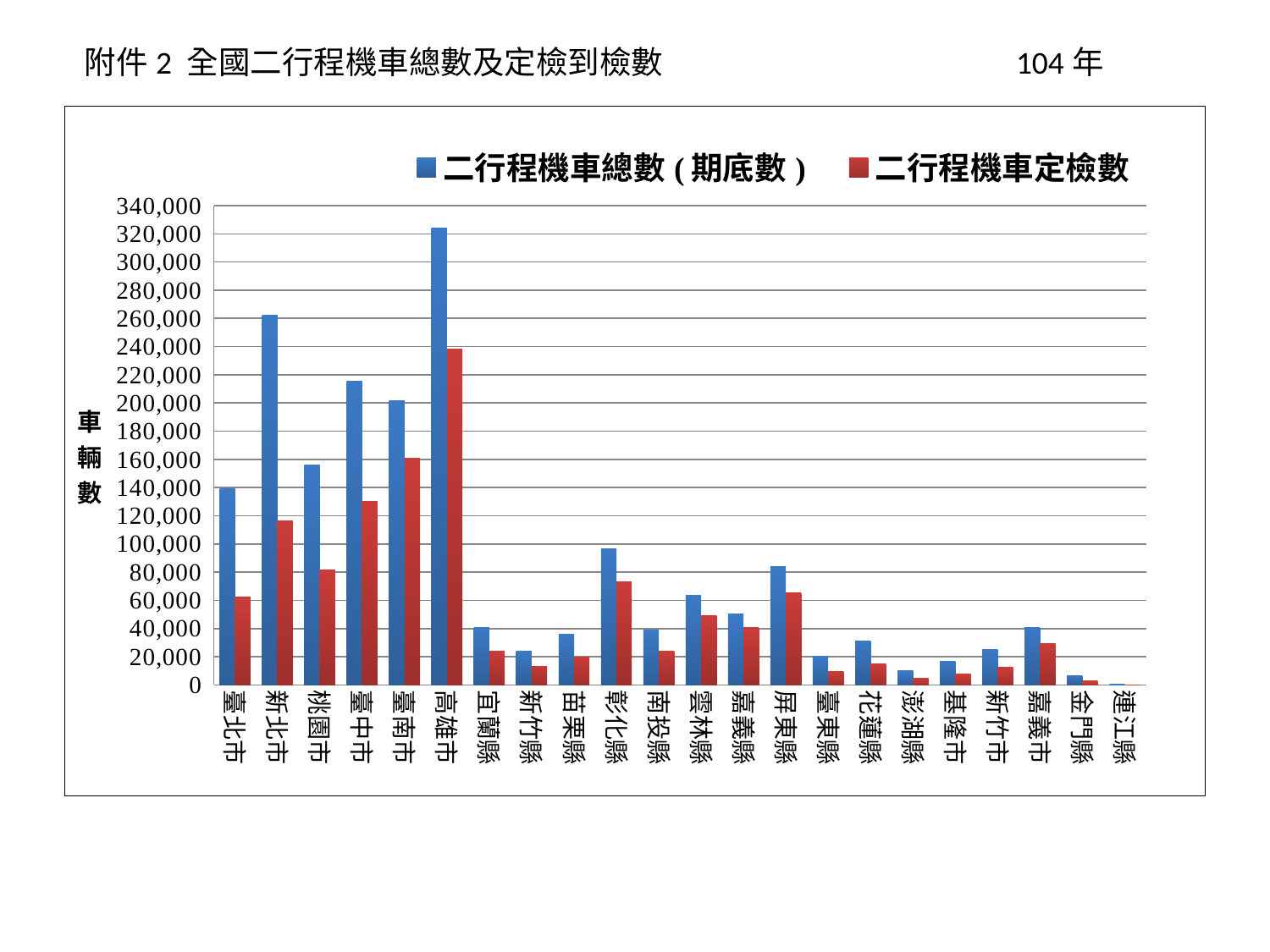
Is the value of 二行程機車總數(期底數) for 高雄市 greater or less than 300,000? greater Which has the larger value for 二行程機車總數(期底數), 臺中市 or 臺南市? 臺中市 Is the value of 二行程機車總數(期底數) for 新北市 greater or less than 240,000? greater How many series does the legend list? 2 Is the value of 二行程機車定檢數 for 高雄市 greater or less than 220,000? greater What kind of chart is shown on the slide? bar chart Which series is shown in red in the legend? 二行程機車定檢數 Which category has the highest value for 二行程機車總數(期底數)? 高雄市 How many categories (cities/counties) are shown on the x axis? 22 Which category has the lowest value for 二行程機車總數(期底數)? 連江縣